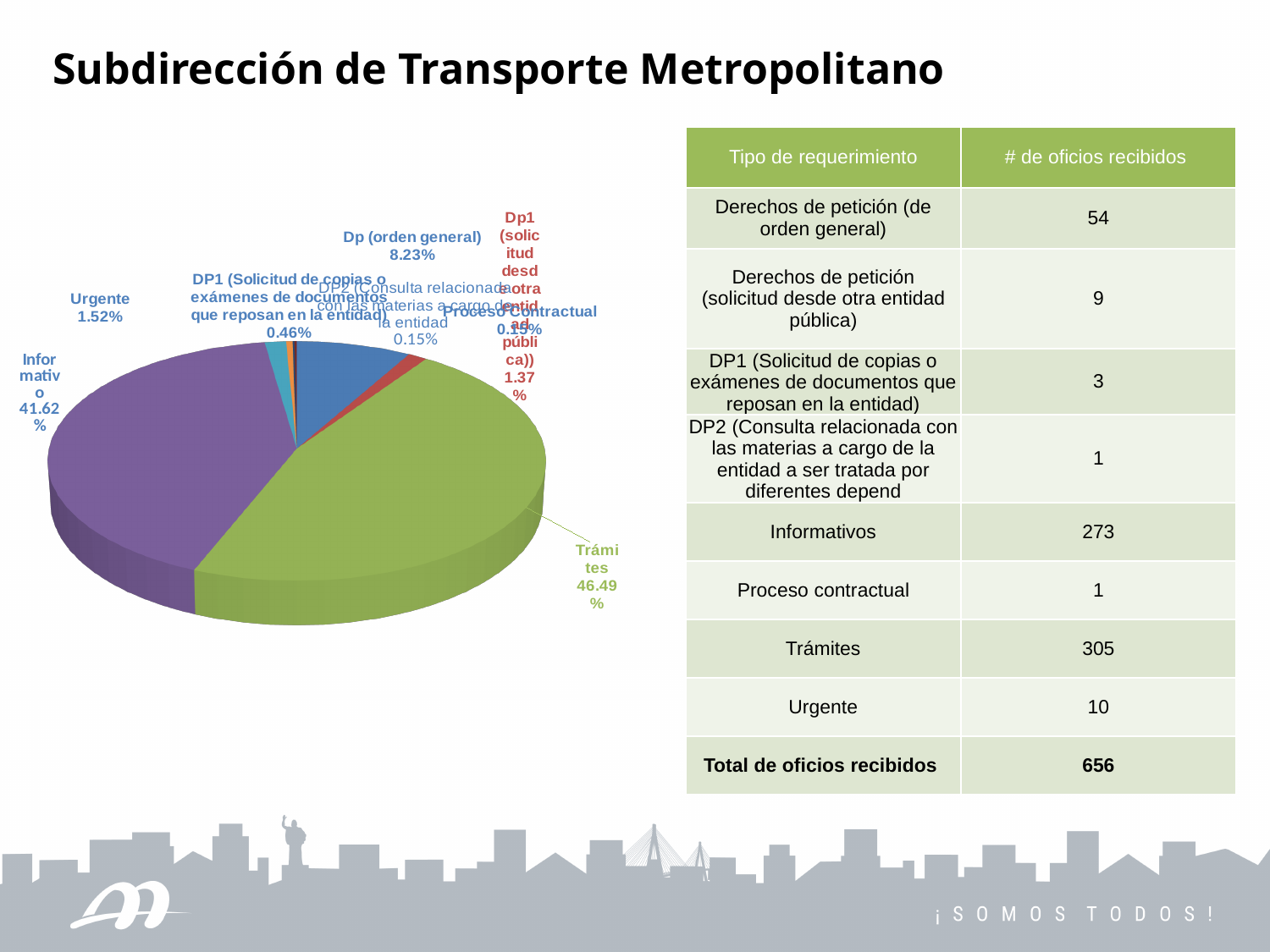
What percentage is shown for the Informativo slice? 41.62% What percentage is shown for Dp (orden general)? 8.23% What percentage is shown for DP1 (Solicitud de copias o exámenes de documentos que reposan en la entidad)? 0.46% What percentage is shown for Proceso contractual? 0.15% What percentage is shown for the Urgente slice? 1.52% What kind of chart is shown on the slide? pie chart Which slice of the pie chart is the largest? Trámites How many slices does the pie chart have? 8 What colour is the Trámites slice in the pie chart? green What share of the pie does the Trámites slice represent? 46.49% What is the difference in percentage points between the Trámites slice and the Informativo slice? 4.87% Which is larger, the Trámites slice or the Informativo slice? Trámites